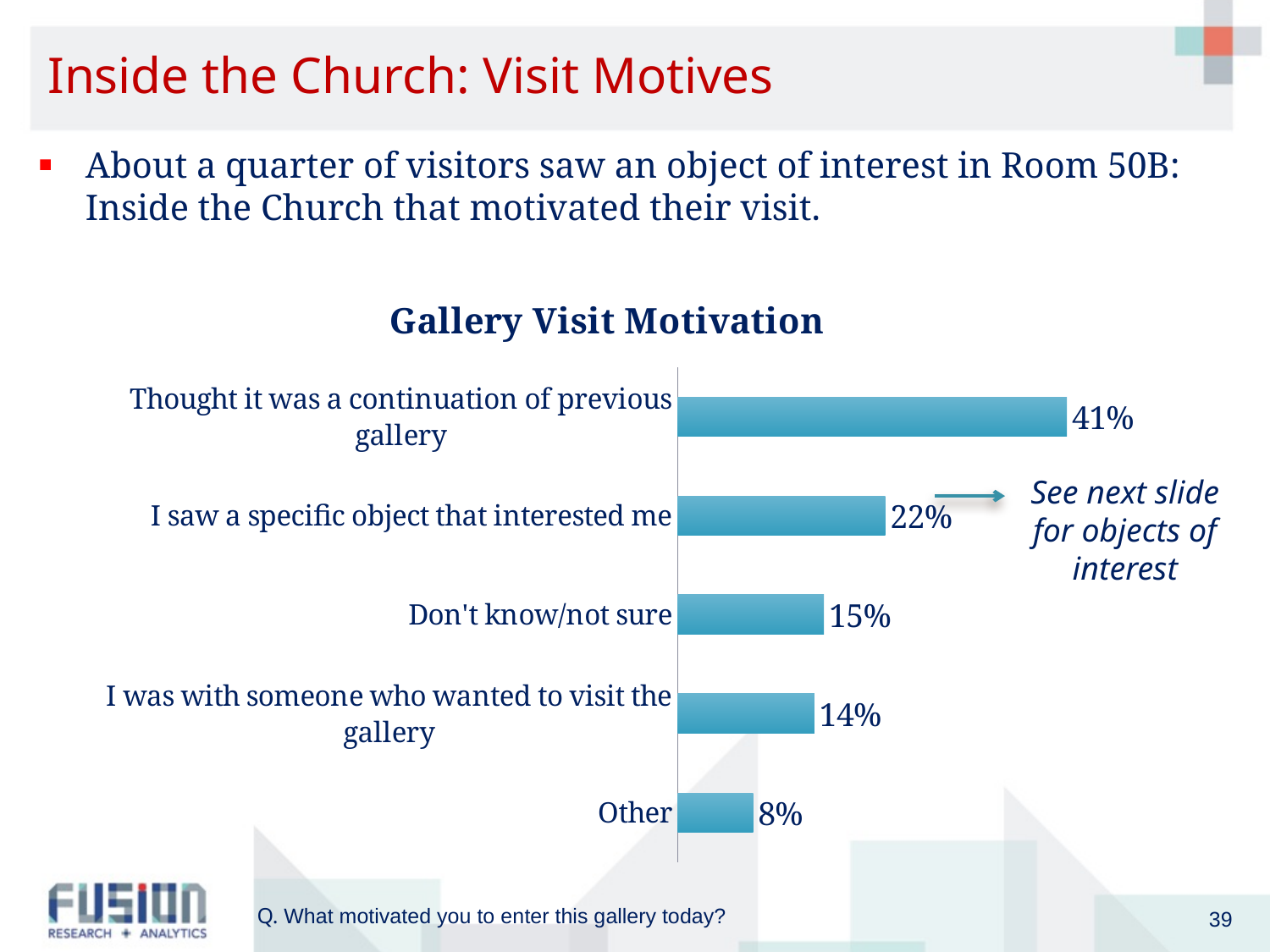
Which is larger: "I saw a specific object that interested me" or "Don't know/not sure"? I saw a specific object that interested me What is the value for "Other"? 8% What is the value for "I was with someone who wanted to visit the gallery"? 14% Which category has the highest value? Thought it was a continuation of previous gallery What kind of chart is shown on the slide? Bar chart What is the value for "Thought it was a continuation of previous gallery"? 41% What is the title of the chart? Gallery Visit Motivation What is the value for "I saw a specific object that interested me"? 22% What is the value for "Don't know/not sure"? 15% Which category has the lowest value? Other How many categories are shown in the chart? 5 What is the difference between "Thought it was a continuation of previous gallery" and "I saw a specific object that interested me"? 19%